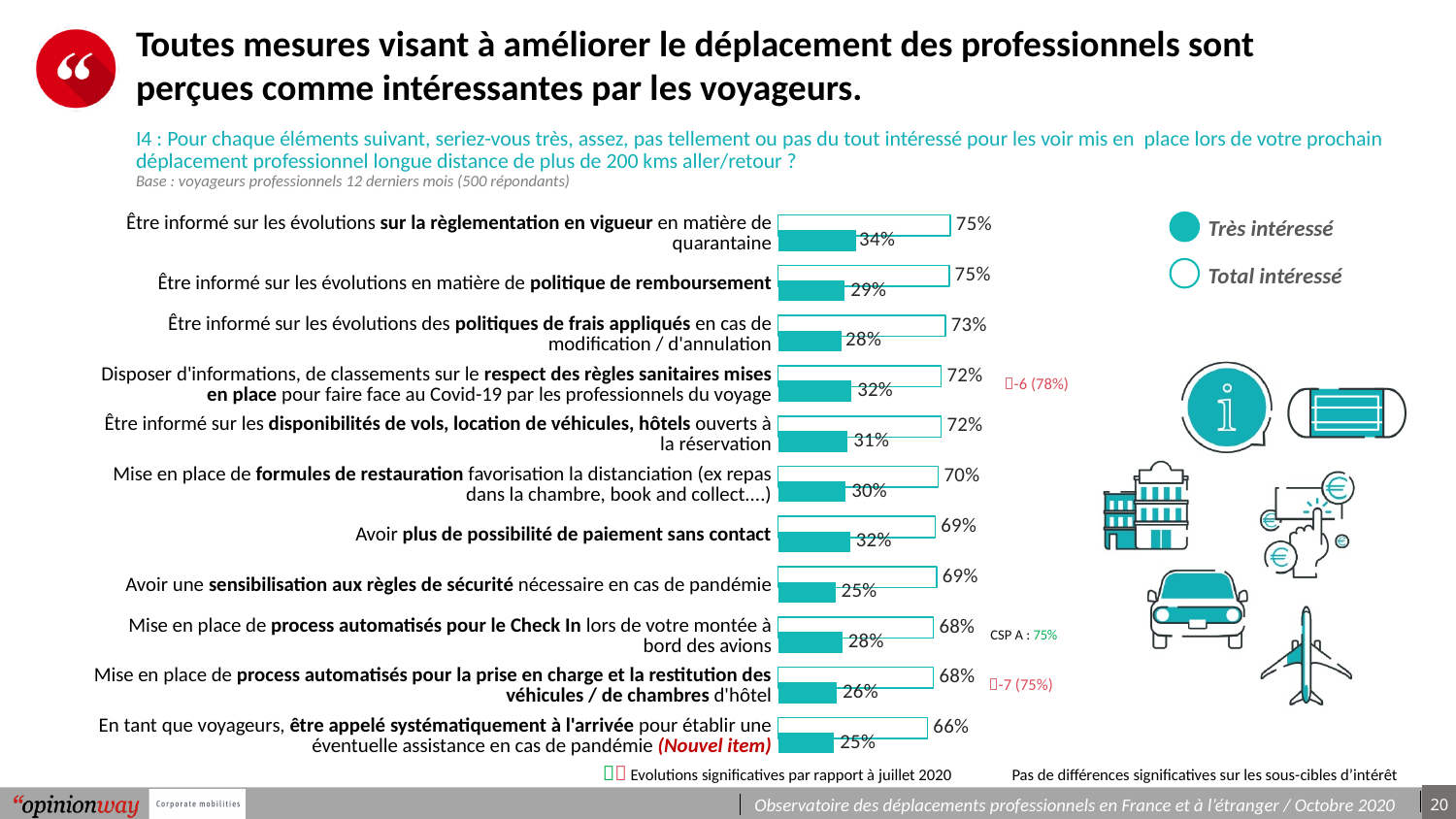
What is the 'Très intéressé' value for 'Avoir plus de possibilité de paiement sans contact'? 32% Which has a higher 'Très intéressé' value: 'Disposer d'informations, de classements sur le respect des règles sanitaires' or 'Mise en place de process automatisés pour la prise en charge et la restitution des véhicules / de chambres d'hôtel'? Disposer d'informations, de classements sur le respect des règles sanitaires How many series does the legend list? 2 What is the 'Très intéressé' value for 'Mise en place de formules de restauration favorisation la distanciation'? 30% Which legend entry is represented by the filled teal bars? Très intéressé Which item has the highest 'Très intéressé' value? Être informé sur les évolutions sur la règlementation en vigueur en matière de quarantaine What is the 'Total intéressé' value for 'Être informé sur les évolutions en matière de politique de remboursement'? 75% What is the difference between the 'Total intéressé' and 'Très intéressé' values for 'Avoir une sensibilisation aux règles de sécurité nécessaire en cas de pandémie'? 44 percentage points Which item has the lowest 'Total intéressé' value? En tant que voyageurs, être appelé systématiquement à l'arrivée pour établir une éventuelle assistance en cas de pandémie Do the 'Total intéressé' values increase or decrease from the top item to the bottom item of the chart? decrease What type of chart is shown on the slide? bar chart How many items (categories) are plotted in the chart? 11